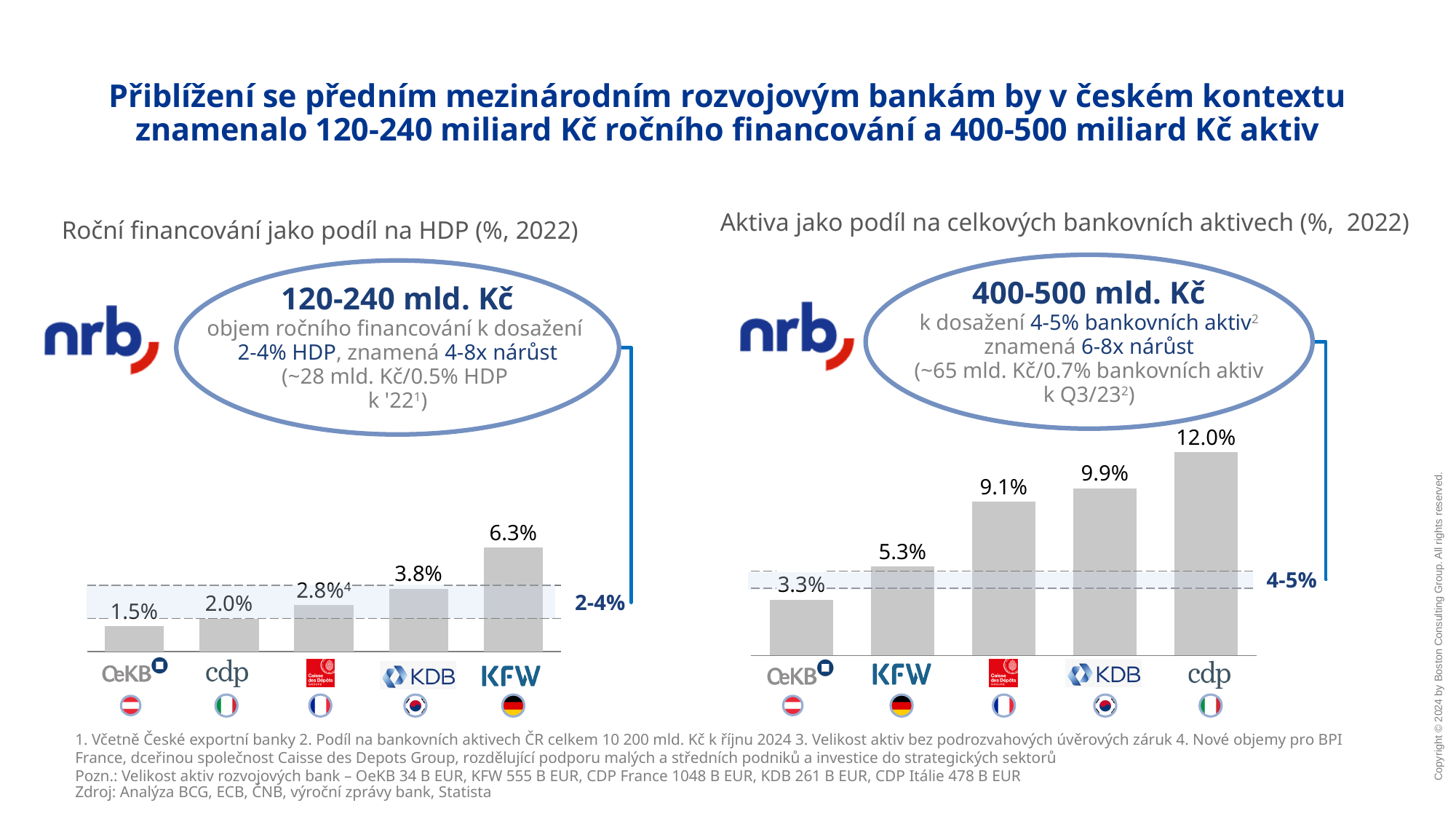
In the left chart (Roční financování jako podíl na HDP), what is the value for KFW? 6.3% In the right chart (Aktiva jako podíl na celkových bankovních aktivech), what is the difference between cdp and KFW? 6.7% In the right chart (Aktiva jako podíl na celkových bankovních aktivech), what is the value for OeKB? 3.3% In the left chart (Roční financování jako podíl na HDP), which bank has the lowest value? OeKB In the left chart (Roční financování jako podíl na HDP), what is the value for KDB? 3.8% In the right chart (Aktiva jako podíl na celkových bankovních aktivech), what is the value for Caisse des Dépôts? 9.1% In the right chart (Aktiva jako podíl na celkových bankovních aktivech), which is larger, KDB or KFW? KDB What type of chart is the left chart (Roční financování jako podíl na HDP)? Bar chart In the right chart (Aktiva jako podíl na celkových bankovních aktivech), do the values rise or fall from left to right? Rise In the left chart (Roční financování jako podíl na HDP), what is the difference between KFW and OeKB? 4.8% In the right chart (Aktiva jako podíl na celkových bankovních aktivech), which bank has the highest value? cdp In the left chart (Roční financování jako podíl na HDP), how many banks are shown? 5